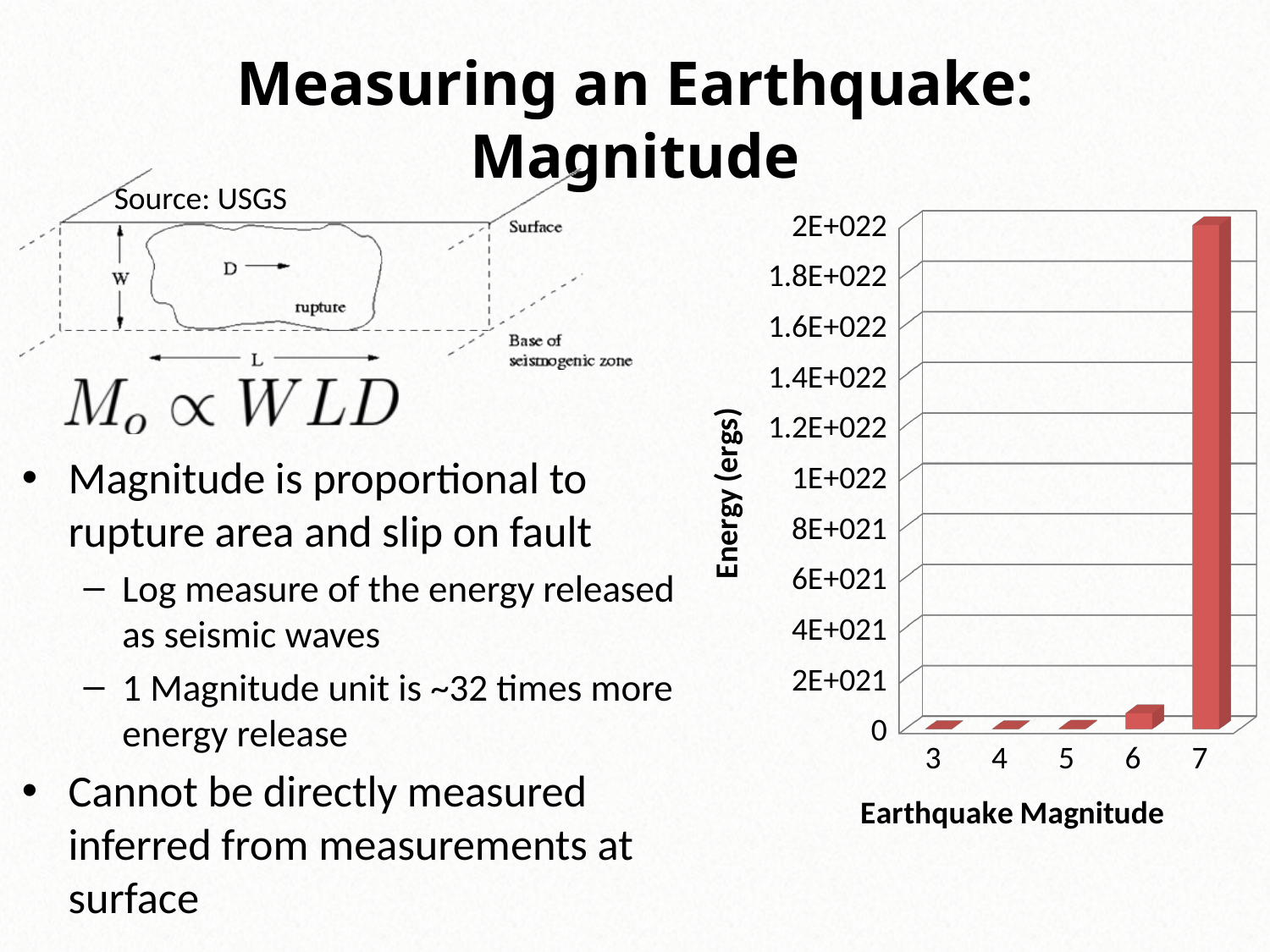
How many earthquake magnitude categories are plotted on the chart? 5 Is the energy for magnitude 6 greater or less than 2E+021 ergs? less Is the energy for magnitude 7 greater or less than 1E+022 ergs? greater Which has the larger energy on the chart, magnitude 5 or magnitude 6? 6 Is the energy for magnitude 7 greater or less than 1.8E+022 ergs? greater Do the energy values rise or fall as earthquake magnitude increases along the x axis? rise What is the title of the chart's y axis? Energy (ergs) What is the title of the chart's x axis? Earthquake Magnitude Which earthquake magnitude has the highest energy on the chart? 7 What kind of chart is shown on the slide? bar chart Which has the larger energy on the chart, magnitude 6 or magnitude 7? 7